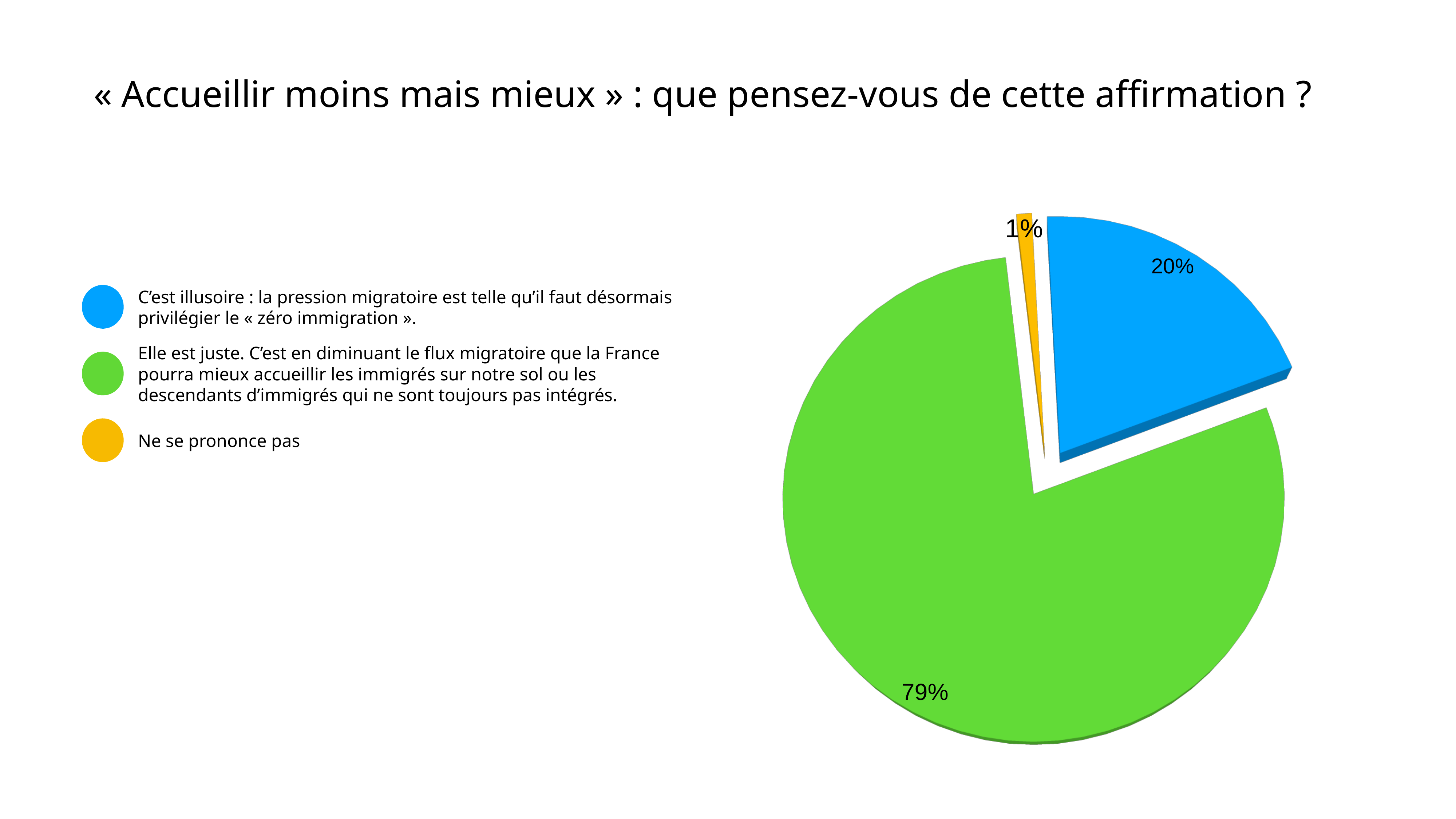
What is the title of the slide? « Accueillir moins mais mieux » : que pensez-vous de cette affirmation ? What colour is the slice representing "Ne se prononce pas"? Yellow What share of respondents chose the answer "Elle est juste..." (the green slice)? 79% What share of respondents chose the answer "C'est illusoire..." (the blue slice)? 20% Which response has the largest share of the pie? Elle est juste. C'est en diminuant le flux migratoire que la France pourra mieux accueillir les immigrés sur notre sol ou les descendants d'immigrés qui ne sont toujours pas intégrés. Which response has the smallest share of the pie? Ne se prononce pas What share of respondents answered "Ne se prononce pas"? 1% Which is larger: the share for "C'est illusoire..." or the share for "Ne se prononce pas"? C'est illusoire... What kind of chart is shown on the slide? Pie chart What is the combined share of the blue and yellow slices? 21% What is the difference in percentage points between the green slice (79%) and the blue slice (20%)? 59 How many slices does the pie chart have? 3